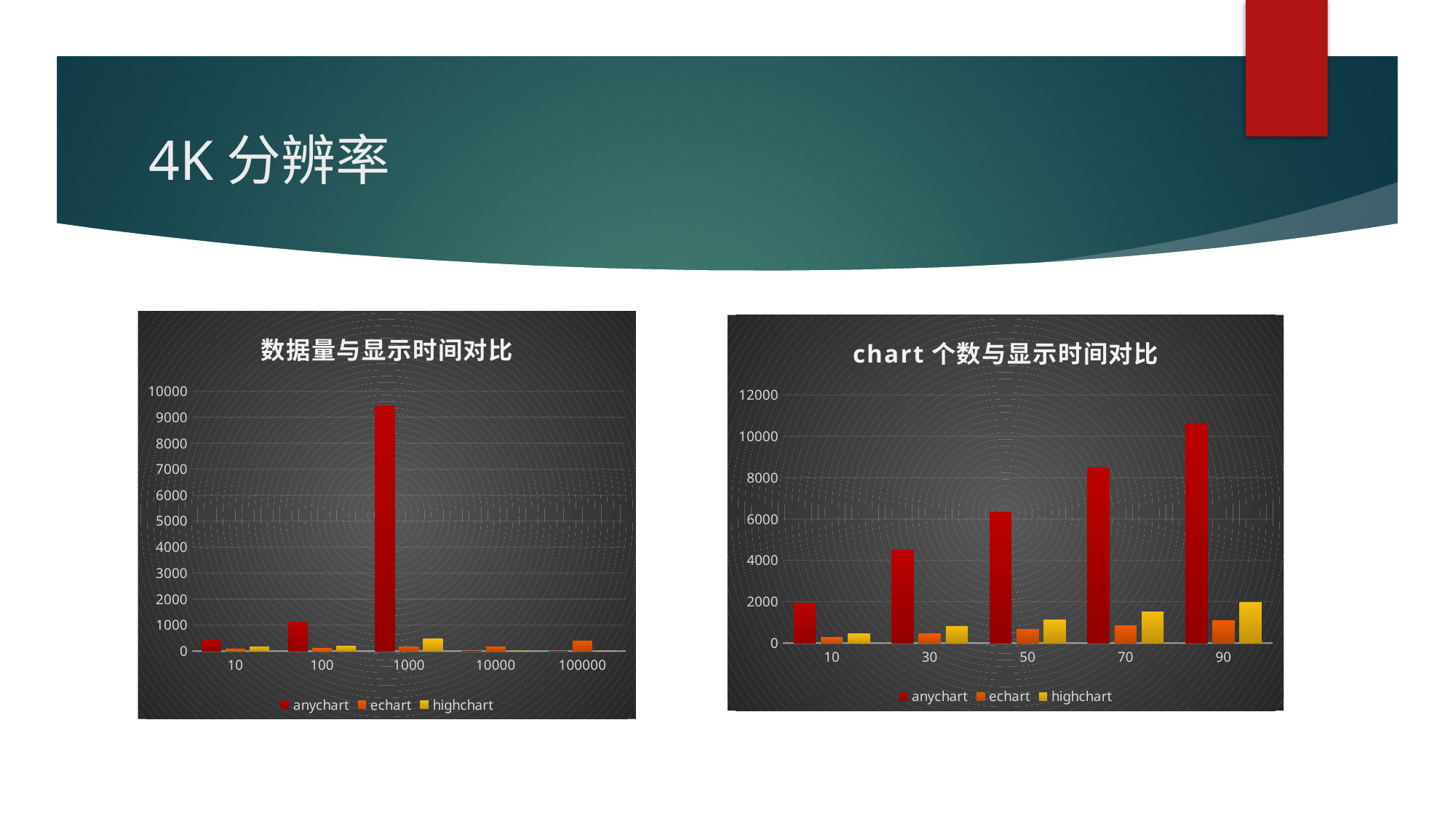
What kind of chart is the left chart titled 数据量与显示时间对比? bar chart In the right chart (chart 个数与显示时间对比), is the anychart value at 10 greater or less than 4000? less What is the title of the right chart? chart 个数与显示时间对比 How many series does the legend of the right chart (chart 个数与显示时间对比) list? 3 Which series is shown in yellow in the left chart's legend? highchart In the right chart (chart 个数与显示时间对比), do the anychart values rise or fall as the x axis goes from 10 to 90? rise How many categories are shown on the x axis of the left chart (数据量与显示时间对比)? 5 In the right chart (chart 个数与显示时间对比), is the anychart value at 90 greater or less than 10000? greater In the left chart (数据量与显示时间对比), at which x-axis category is the anychart bar highest? 1000 In the left chart (数据量与显示时间对比), is the anychart value at 1000 greater or less than 9000? greater In the right chart (chart 个数与显示时间对比), which series has the highest bar at 70? anychart In the right chart (chart 个数与显示时间对比), which is larger at 90: anychart or highchart? anychart